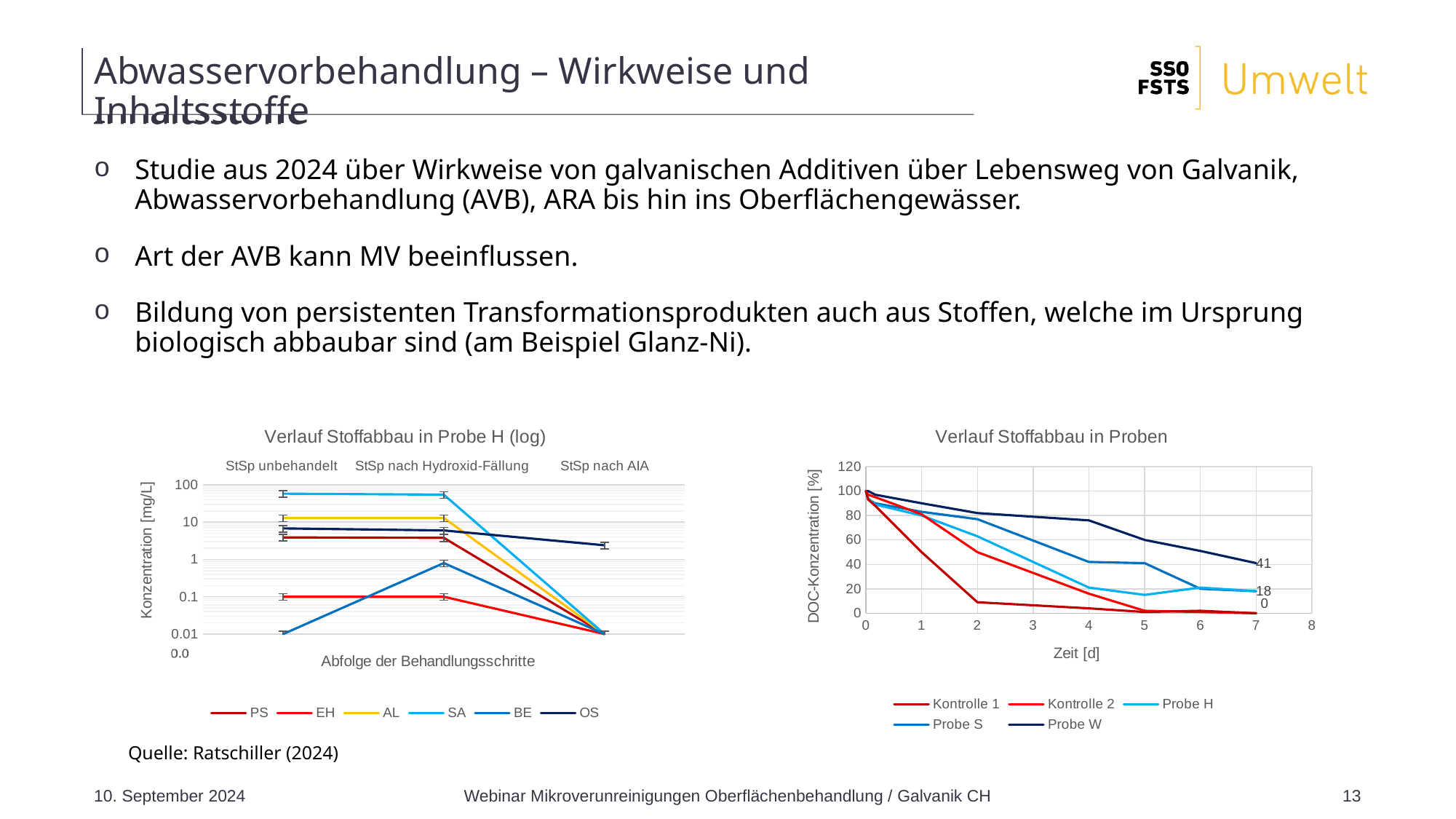
How many series does the legend of 'Verlauf Stoffabbau in Proben' list? 5 In 'Verlauf Stoffabbau in Proben', is the value for Kontrolle 1 at day 2 greater or less than 20? less In 'Verlauf Stoffabbau in Probe H (log)', is the value for OS at 'StSp nach AIA' greater or less than 1? greater How many treatment steps are shown on the x axis of 'Verlauf Stoffabbau in Probe H (log)'? 3 In 'Verlauf Stoffabbau in Proben', do the DOC-Konzentration values rise or fall over time? fall In 'Verlauf Stoffabbau in Probe H (log)', which series has the lowest concentration at 'StSp unbehandelt'? BE In 'Verlauf Stoffabbau in Proben', which series has the highest value at day 7? Probe W How many series does the legend of 'Verlauf Stoffabbau in Probe H (log)' list? 6 In 'Verlauf Stoffabbau in Proben', is the value for Probe W at day 4 greater or less than 60? greater In 'Verlauf Stoffabbau in Proben', what is the DOC-Konzentration of Probe W at day 7? 41 What kind of chart is 'Verlauf Stoffabbau in Proben'? line chart In 'Verlauf Stoffabbau in Probe H (log)', which series has the highest concentration at 'StSp unbehandelt'? SA